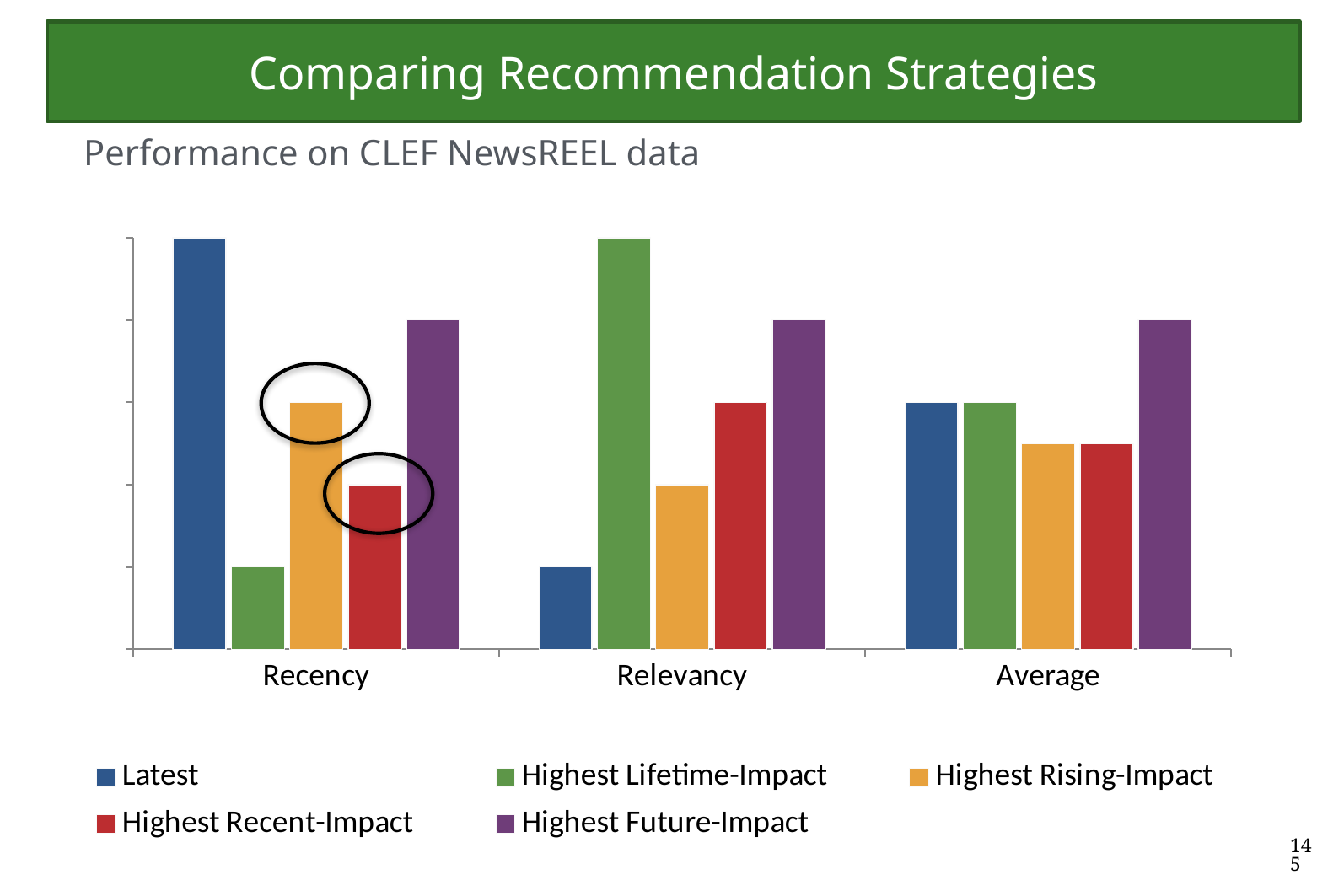
Which colour represents Highest Future-Impact in the chart's legend? purple In the Recency group, which is larger: Highest Rising-Impact or Highest Recent-Impact? Highest Rising-Impact In the Relevancy group, which is larger: Highest Recent-Impact or Highest Rising-Impact? Highest Recent-Impact How many series does the chart's legend list? 5 In the Average group, which strategy has the highest bar? Highest Future-Impact In the Relevancy group, which strategy has the lowest bar? Latest What kind of chart is shown on the slide? bar chart How many categories are shown on the x axis of the chart? 3 In the Relevancy group, which strategy has the highest bar? Highest Lifetime-Impact What is the title of the slide containing the chart? Comparing Recommendation Strategies In the Recency group, which strategy has the highest bar? Latest In the Recency group, which strategy has the lowest bar? Highest Lifetime-Impact